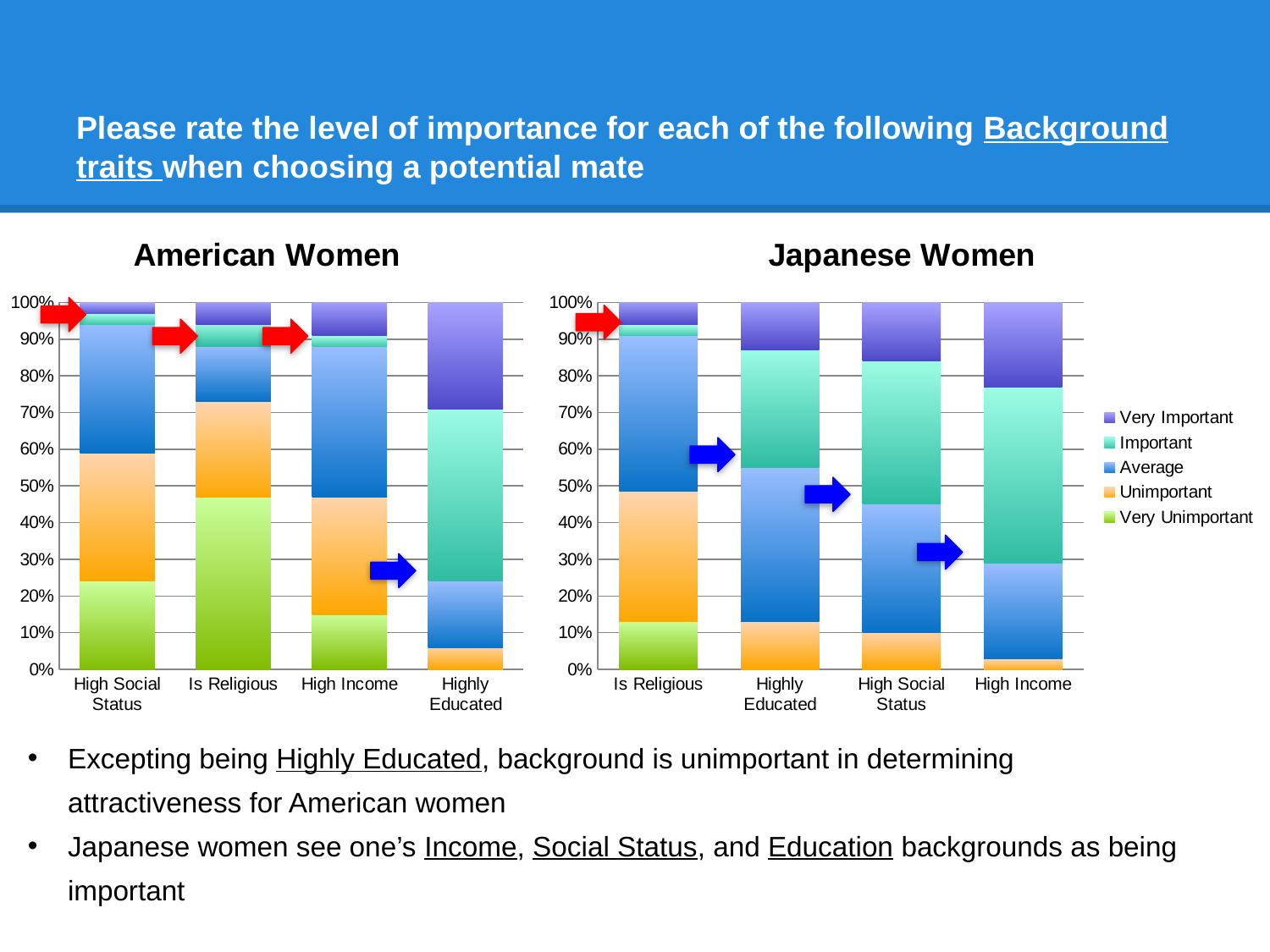
In the Japanese Women chart, which category is the only one with a Very Unimportant segment? Is Religious In the American Women chart, which is larger: the Very Unimportant segment for Is Religious or for High Income? Is Religious In the American Women chart, which category has the largest Very Important segment? Highly Educated What kind of chart is the American Women chart? stacked bar chart Which series is listed first in the legend? Very Important How many series does the legend list for the charts? 5 In the Japanese Women chart, which category has the largest Very Important segment? High Income In the American Women chart, which category has the largest Very Unimportant segment? Is Religious How many categories are shown on the x axis of the Japanese Women chart? 4 In the American Women chart, is the Very Unimportant value for Is Religious greater or less than 40%? greater In the American Women chart, is the Unimportant value for Highly Educated greater or less than 10%? less In the Japanese Women chart, is the Unimportant value for High Income greater or less than 10%? less